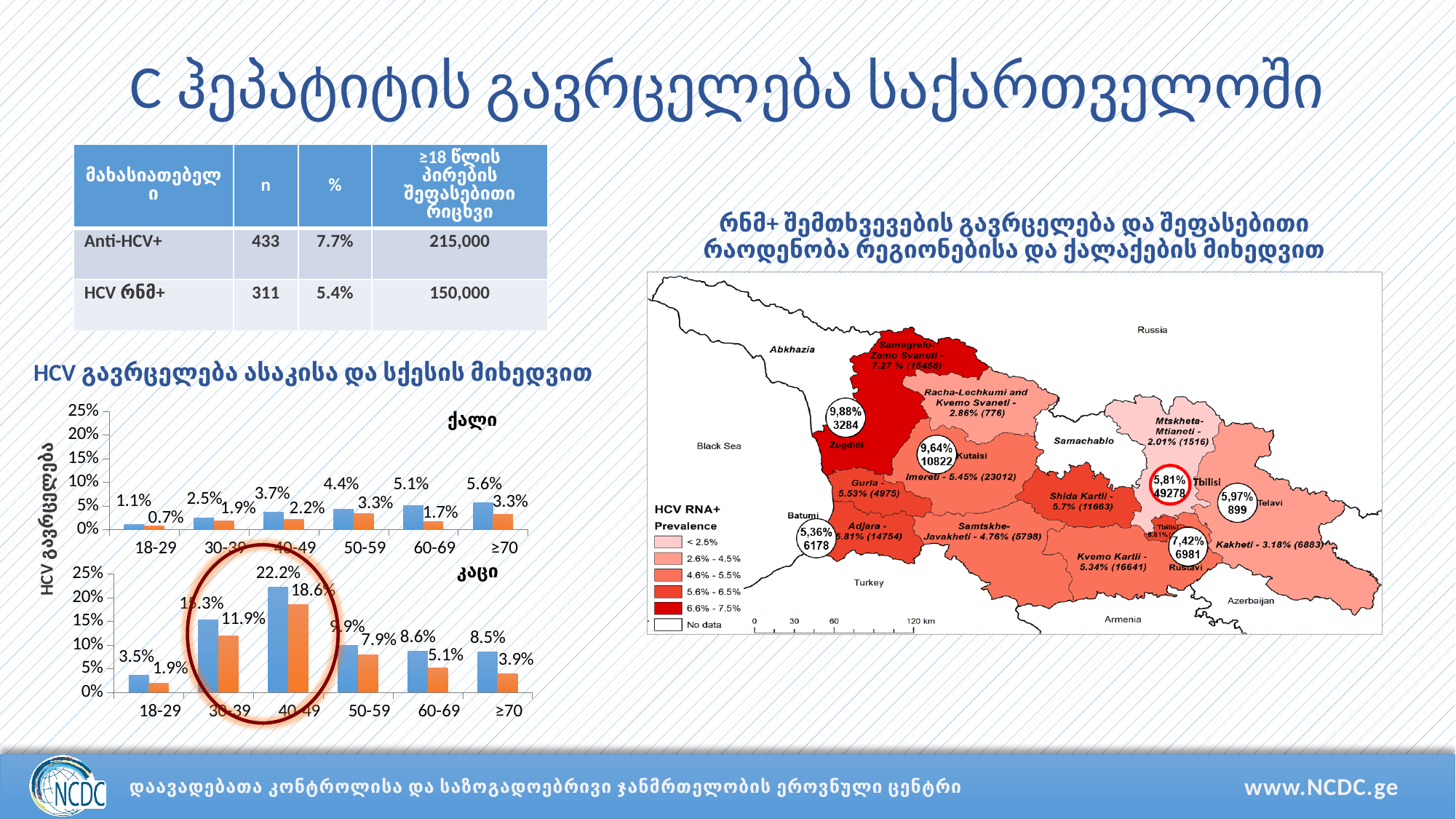
How many age groups are shown on the x axis of the top bar chart (ქალი)? 6 In the top bar chart (ქალი), do the blue bars rise or fall as age increases from 18-29 to ≥70? Rise In the top bar chart (ქალი), what is the value of the orange bar for the 18-29 age group? 0.7% In the bottom bar chart (კაცი), which age group has the highest blue bar? 40-49 In the bottom bar chart (კაცი), what is the value of the blue bar for the 40-49 age group? 22.2% What type of chart is used to show HCV prevalence by age and sex on the left of the slide? Bar chart In the bottom bar chart (კაცი), what is the difference between the blue and orange bars for the 40-49 age group? 3.6% In the bottom bar chart (კაცი), is the blue bar for 40-49 greater or less than 20%? greater In the top bar chart (ქალი), what is the value of the blue bar for the ≥70 age group? 5.6% In the top bar chart (ქალი), which age group has the lowest blue bar? 18-29 In the bottom bar chart (კაცი), what is the value of the orange bar for the 30-39 age group? 11.9% In the bottom bar chart (კაცი), is the blue bar for 30-39 or the blue bar for 50-59 larger? 30-39